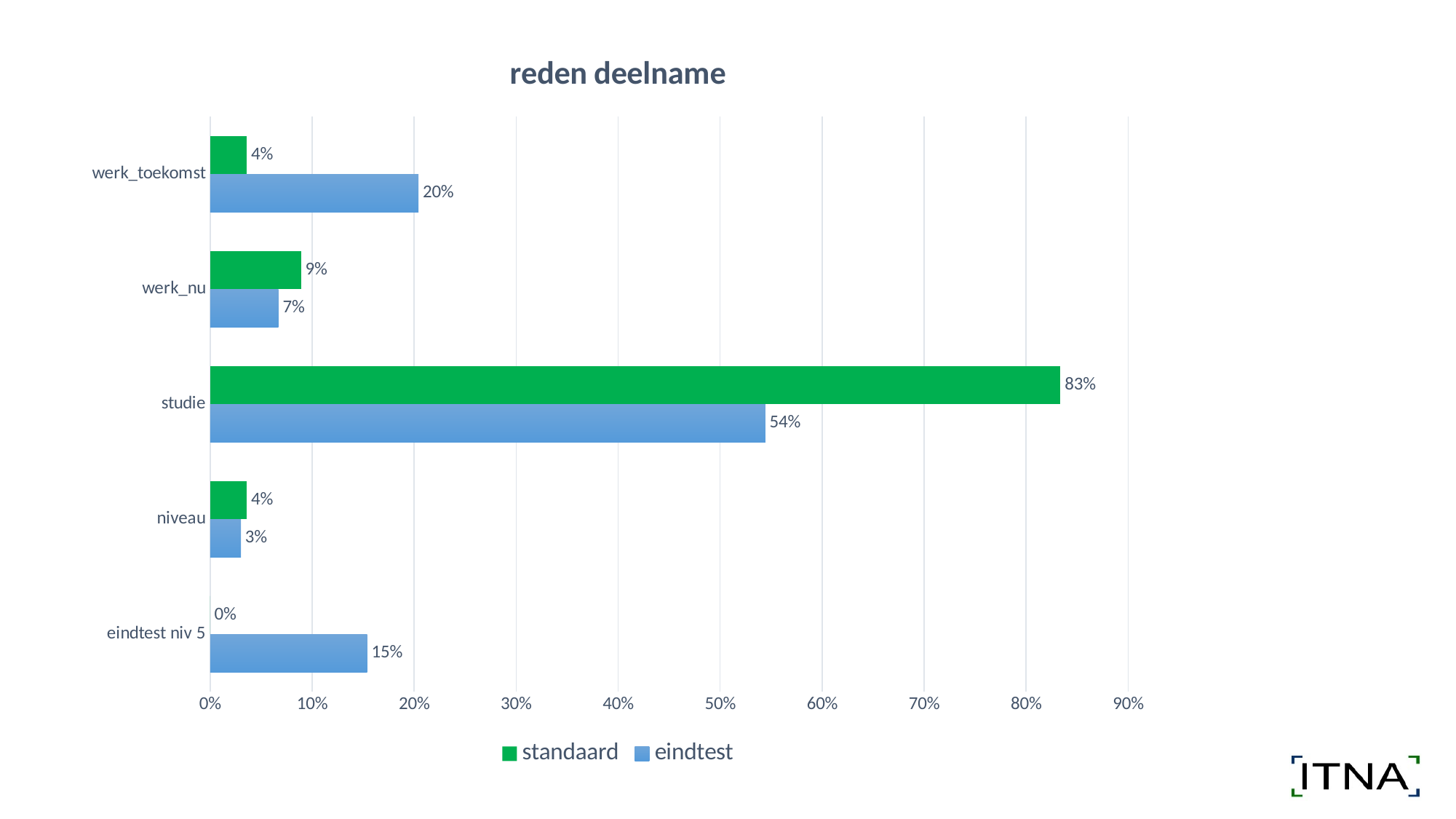
How many series does the legend list? 2 What is the value for werk_toekomst in the eindtest series? 20% What is the value for studie in the standaard series? 83% How many categories are shown on the chart? 5 Which category has the lowest value in the standaard series? eindtest niv 5 What kind of chart is shown on the slide? bar chart Which category has the highest value in the eindtest series? studie What is the title of the chart? reden deelname For werk_nu, which series has the larger value, standaard or eindtest? standaard What is the difference between the standaard and eindtest values for studie? 29% Is the eindtest value for studie greater or less than 50%? greater What is the value for eindtest niv 5 in the standaard series? 0%